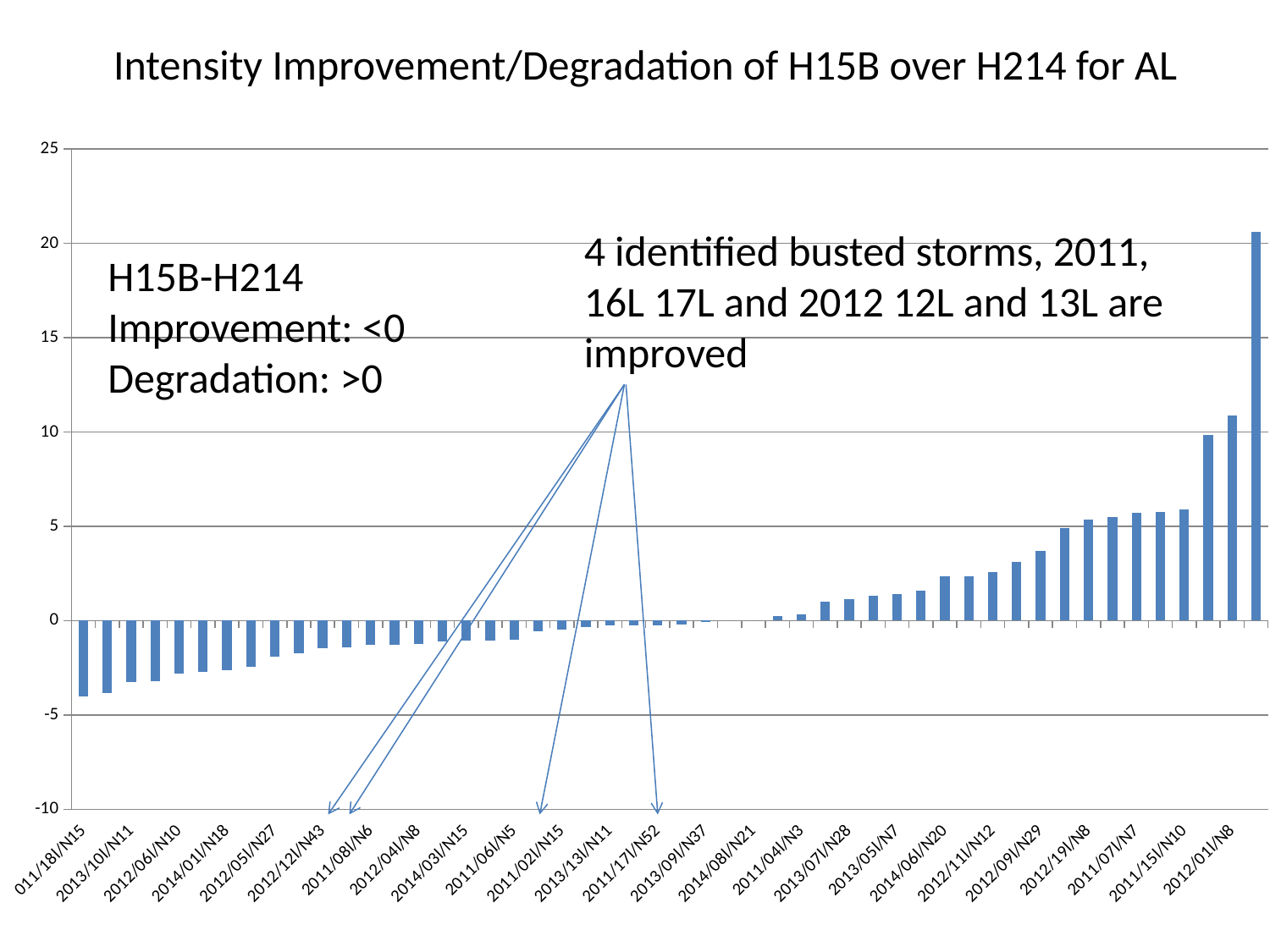
Which bar has the highest value on the chart? the rightmost bar What is the title of the chart? Intensity Improvement/Degradation of H15B over H214 for AL Which bar is higher, the leftmost bar or the rightmost bar? the rightmost bar According to the text on the slide, how many identified busted storms are improved? 4 Is the value of the rightmost bar greater or less than 15? greater Which bar has the lowest value on the chart? the leftmost bar Is the value of the leftmost bar greater or less than -5? greater Do the bar values rise or fall moving from left to right along the x axis? rise Is the value of the leftmost bar greater or less than 0? less What kind of chart is shown on the slide? bar chart